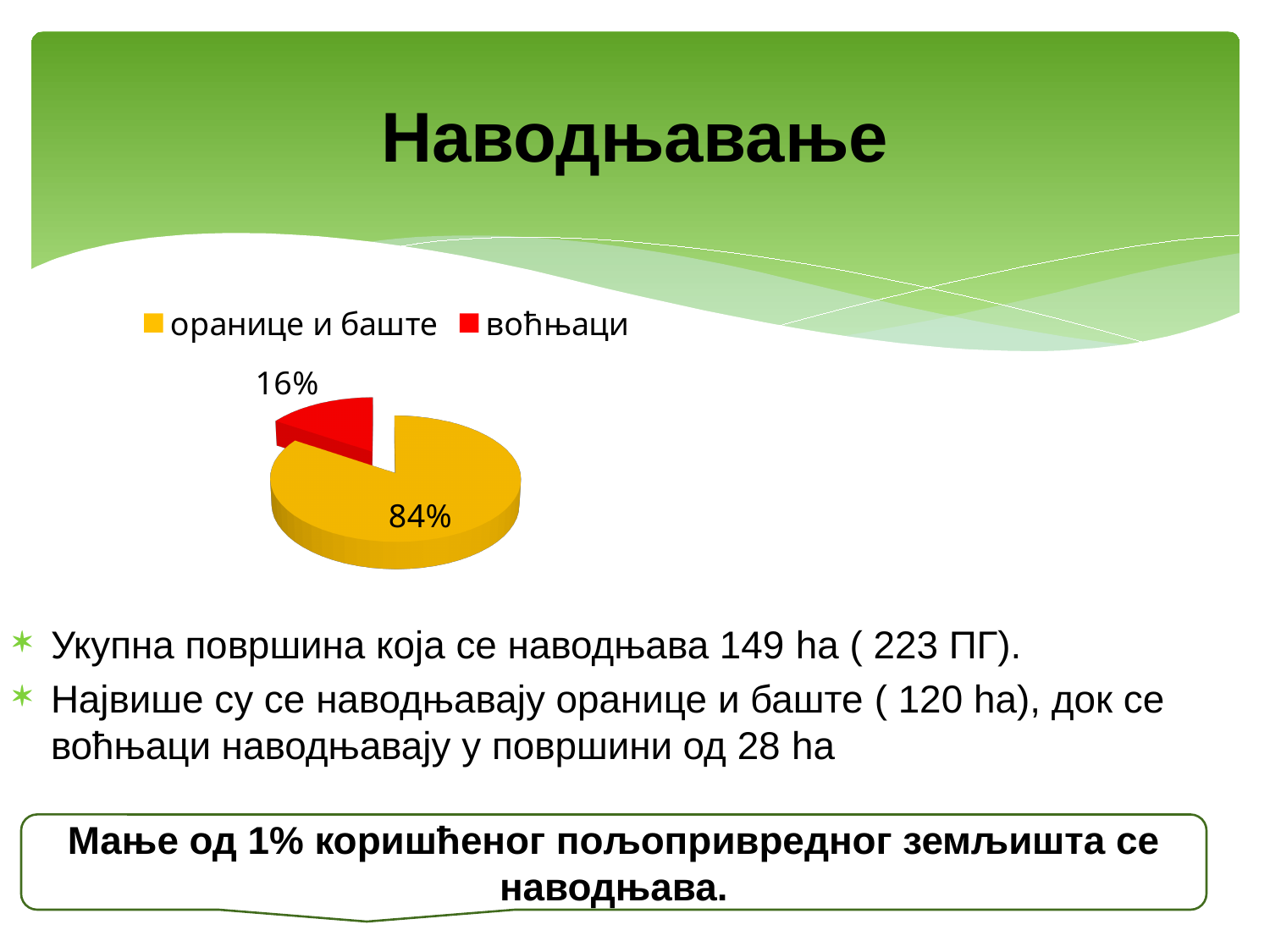
How many slices does the pie chart have? 2 Which slice is larger, "оранице и баште" or "воћњаци"? оранице и баште Which category has the largest slice of the pie? оранице и баште Which category has the smallest slice of the pie? воћњаци What colour is the "воћњаци" slice? red What is the difference in percentage points between the "оранице и баште" slice and the "воћњаци" slice? 68 What share of the pie does "воћњаци" have? 16% How many entries does the legend list? 2 What colour is the "оранице и баште" slice? yellow What share of the pie does "оранице и баште" have? 84% What kind of chart is shown on the slide? pie chart